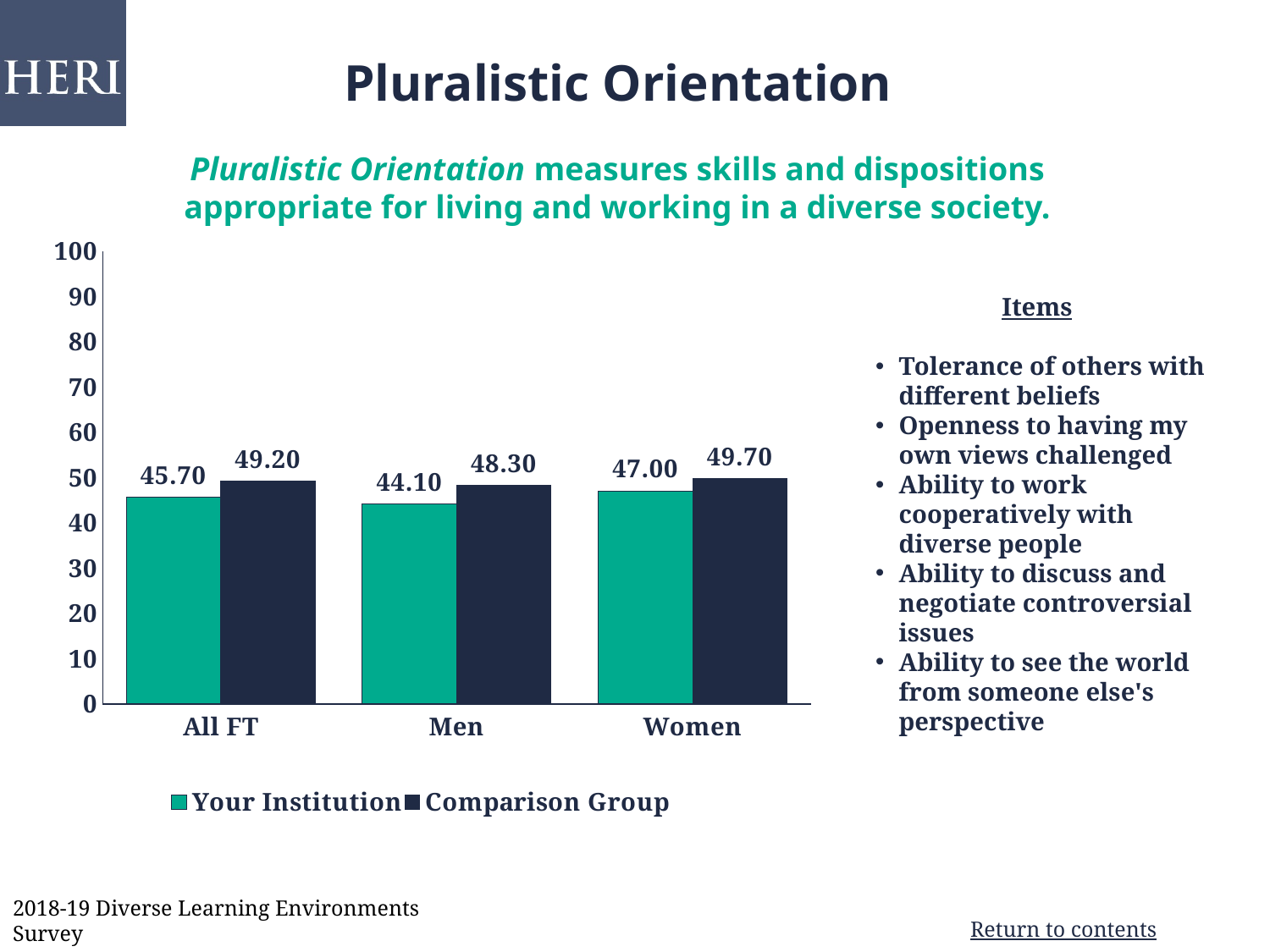
Which category has the highest value for the Comparison Group series? Women What is the value for Comparison Group in the Women category? 49.70 What is the value for Your Institution in the Men category? 44.10 What is the value for Your Institution in the All FT category? 45.70 What is the difference between the Comparison Group and Your Institution values in the Men category? 4.20 Is the value for Your Institution in the All FT category greater or less than 50? less How many series does the legend list? 2 Which is larger in the Women category: Your Institution or Comparison Group? Comparison Group What kind of chart is shown on the slide? bar chart How many categories are shown on the x axis? 3 Which category has the lowest value for the Your Institution series? Men What is the maximum value shown on the y axis? 100